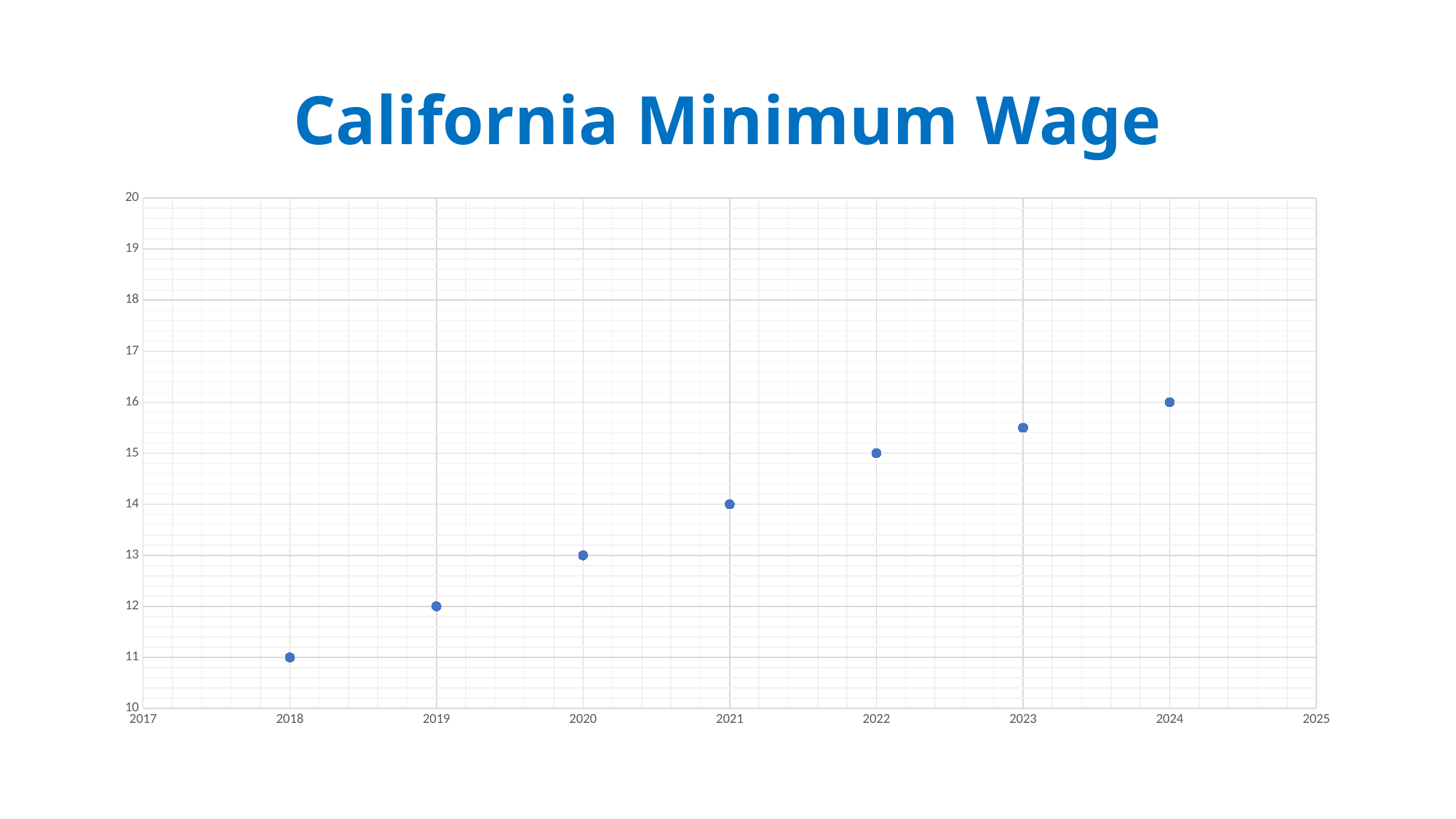
Do the values rise or fall from 2018 to 2024? rise Which year has the highest value? 2024 What is the value for 2018? 11 What is the value for 2022? 15 What is the value for 2024? 16 Is the value for 2023 greater or less than 15? greater Which is larger, the value for 2021 or the value for 2019? 2021 What kind of chart is this? scatter chart How many data points are plotted? 7 Which year has the lowest value? 2018 What is the difference between the values for 2024 and 2018? 5 What is the value for 2020? 13